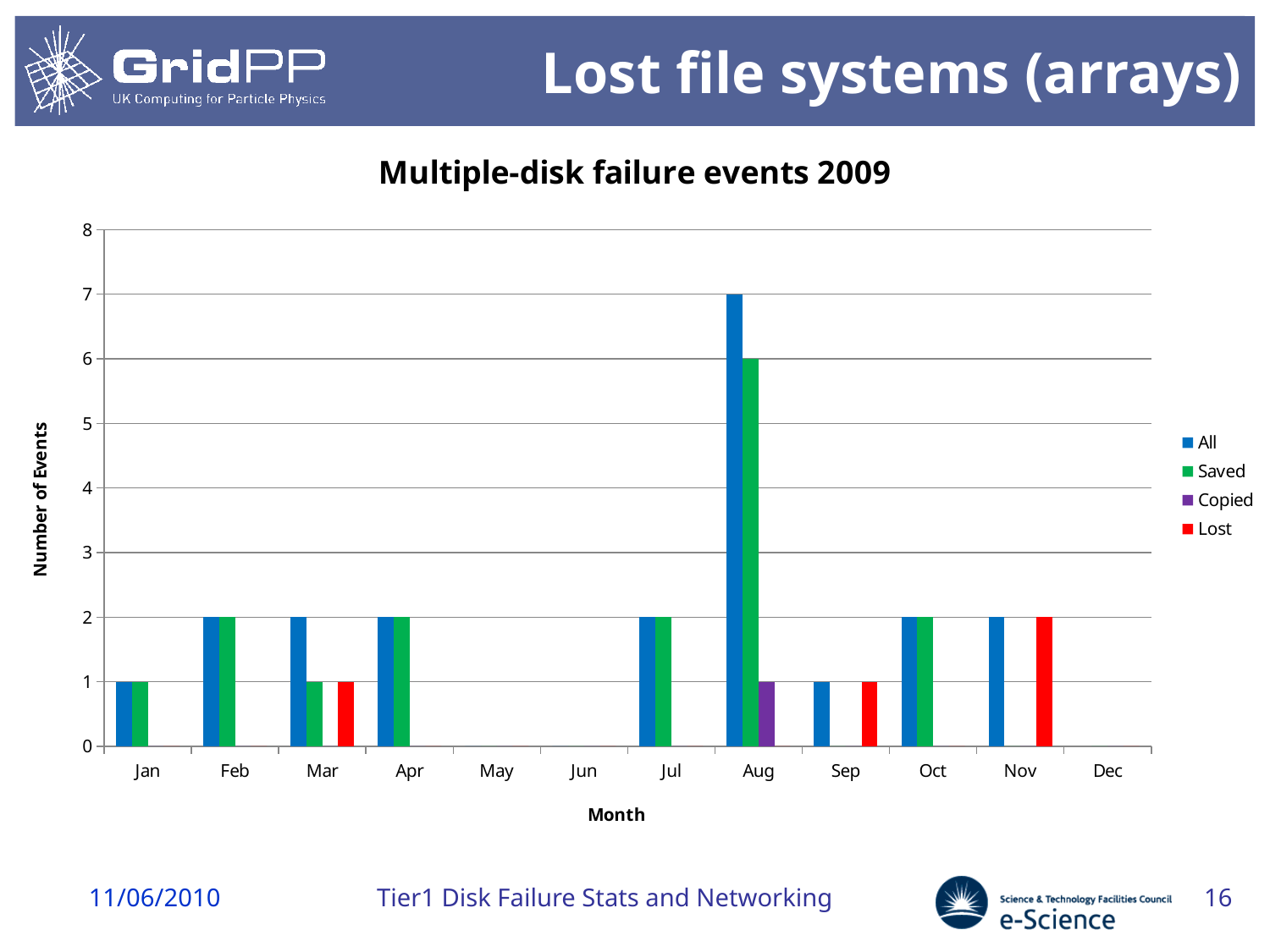
How many months are shown on the x axis? 12 Which is larger, the Lost value for Mar or the Lost value for Nov? Nov What is the value of the All series for Aug? 7 What is the value of the Lost series for Nov? 2 What is the value of the Saved series for Aug? 6 What is the difference between the All and Saved values for Aug? 1 What is the label of the y axis? Number of Events Which month has the highest value for the All series? Aug What kind of chart is shown on the slide? bar chart What is the title of the chart? Multiple-disk failure events 2009 How many series does the legend list? 4 In which month does the Copied series have a non-zero value? Aug